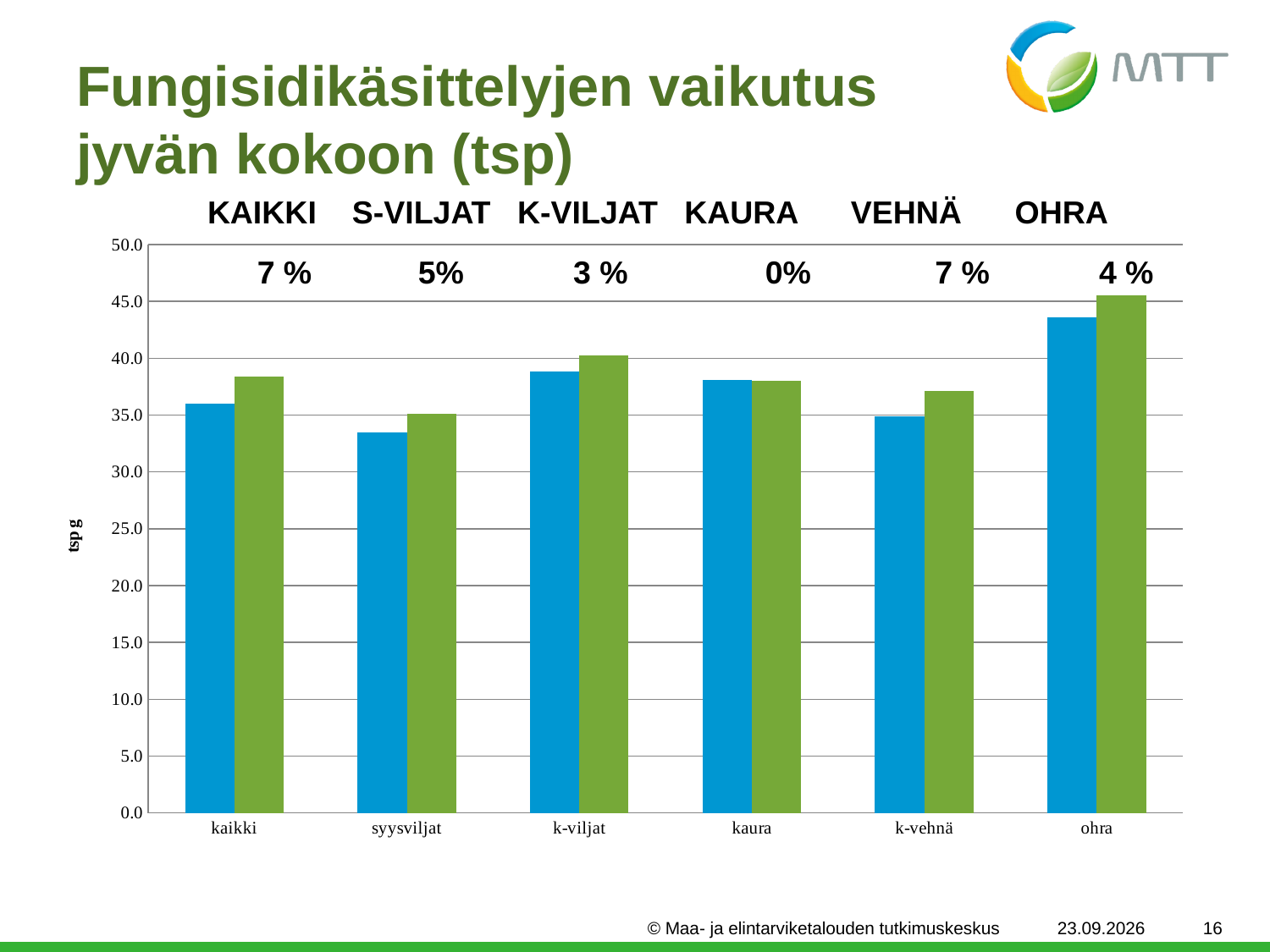
Which is larger, the blue bar for ohra or the blue bar for kaikki? ohra Is the blue bar for syysviljat greater or less than 35.0? less Is the blue bar for k-vehnä greater or less than 30.0? greater How many categories are shown along the x axis of the chart? 6 Is the blue bar for ohra greater or less than 40.0? greater Which category has the shortest bar in the chart? syysviljat What kind of chart is shown on the slide? bar chart Which category has the tallest bar in the chart? ohra Which is larger, the green bar for k-viljat or the green bar for syysviljat? k-viljat What is the label on the vertical axis of the chart? tsp g What percentage is printed above the KAURA group in the chart? 0%